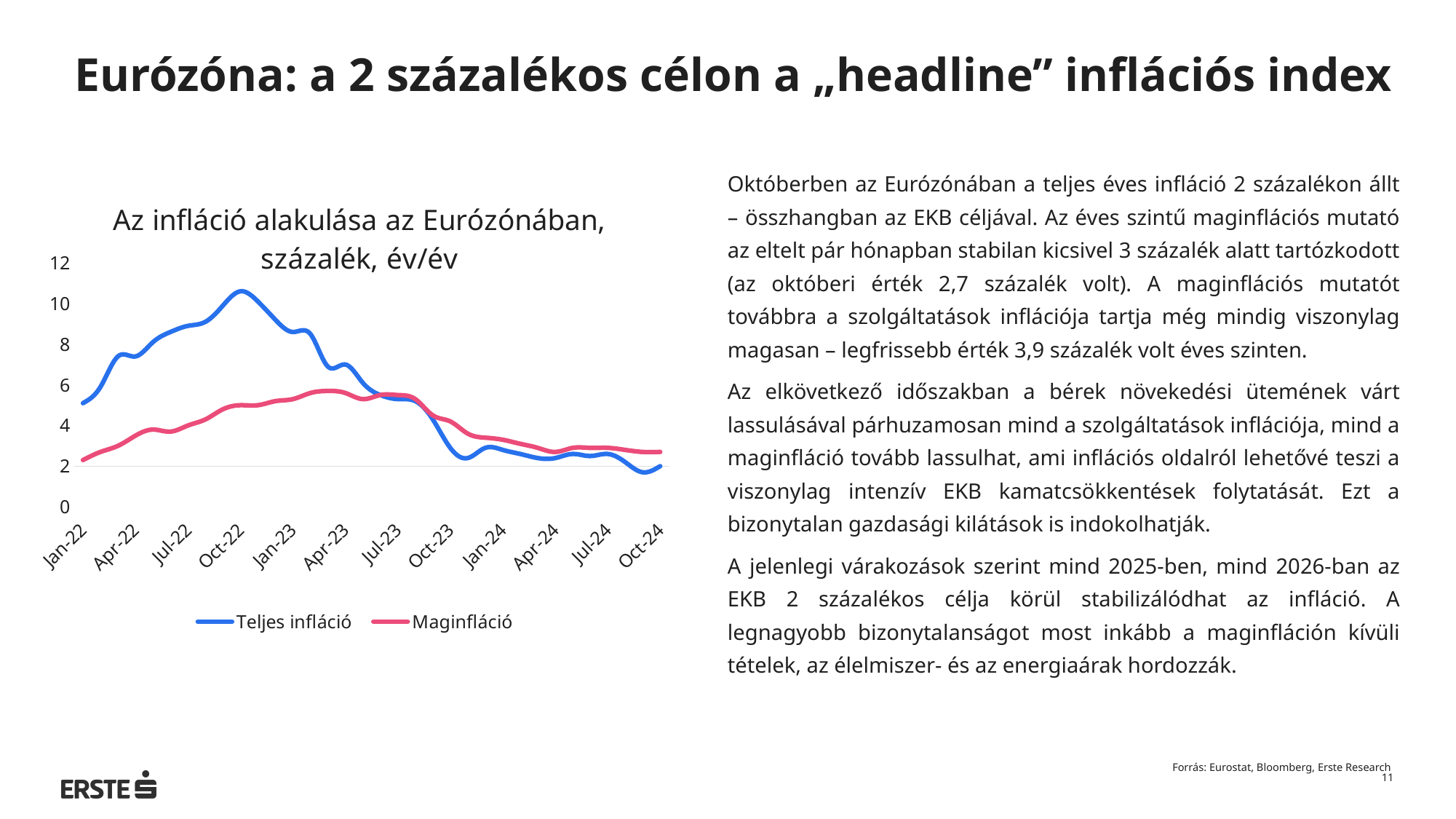
How many date labels are shown on the x axis of the chart? 12 Does the Teljes infláció line rise or fall between Oct-22 and Oct-24? fall Does the Maginfláció line rise or fall between Jan-22 and Apr-23? rise What is the title of the chart? Az infláció alakulása az Eurózónában, százalék, év/év How many series does the chart's legend list? 2 Is the value of Maginfláció at Jan-22 greater or less than 4? less Which colour is used for the Teljes infláció line? blue Which series has the higher value at Oct-24, Teljes infláció or Maginfláció? Maginfláció Is the peak value of Teljes infláció around Oct-22 greater or less than 10? greater Is the value of Teljes infláció at Jan-22 greater or less than 4? greater What kind of chart is shown on the slide? line chart Which series reaches the highest value on the chart? Teljes infláció